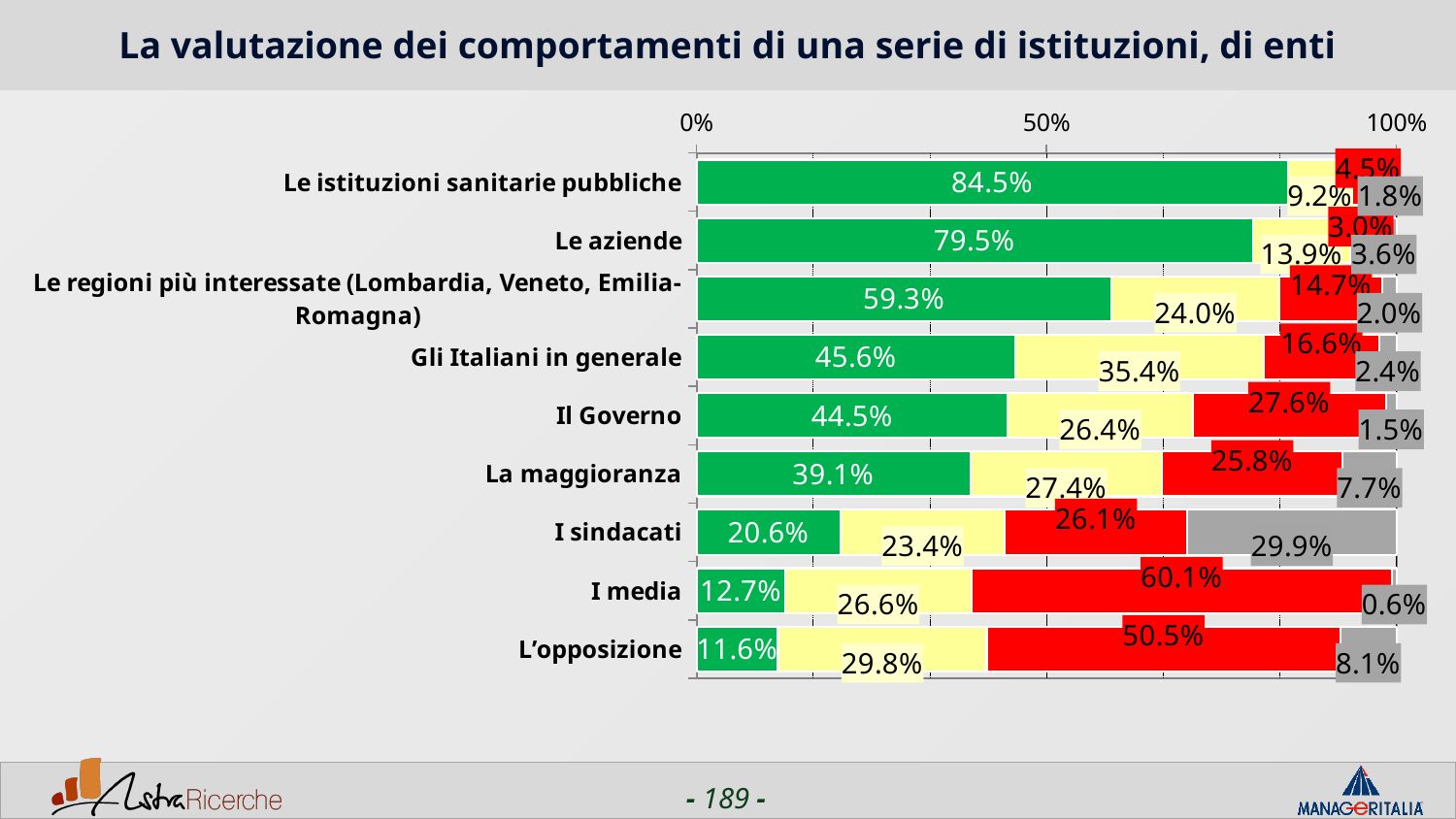
How many categories are shown on the chart? 9 Which category has the lowest green segment value? L'opposizione What is the value of the grey segment for "I sindacati"? 29.9% What is the value of the yellow segment for "Gli Italiani in generale"? 35.4% Which category has the highest green segment value? Le istituzioni sanitarie pubbliche What is the total of the stacked bar for "Le aziende"? 100.0% What kind of chart is shown on the slide? Stacked bar chart Is the green segment value for "Le regioni più interessate (Lombardia, Veneto, Emilia-Romagna)" greater or less than 50%? greater What is the value of the green segment for "Le istituzioni sanitarie pubbliche"? 84.5% What is the value of the red segment for "I media"? 60.1% Which has a larger red segment value, "I media" or "L'opposizione"? I media What is the difference between the green segment values of "Le aziende" and "Il Governo"? 35.0%